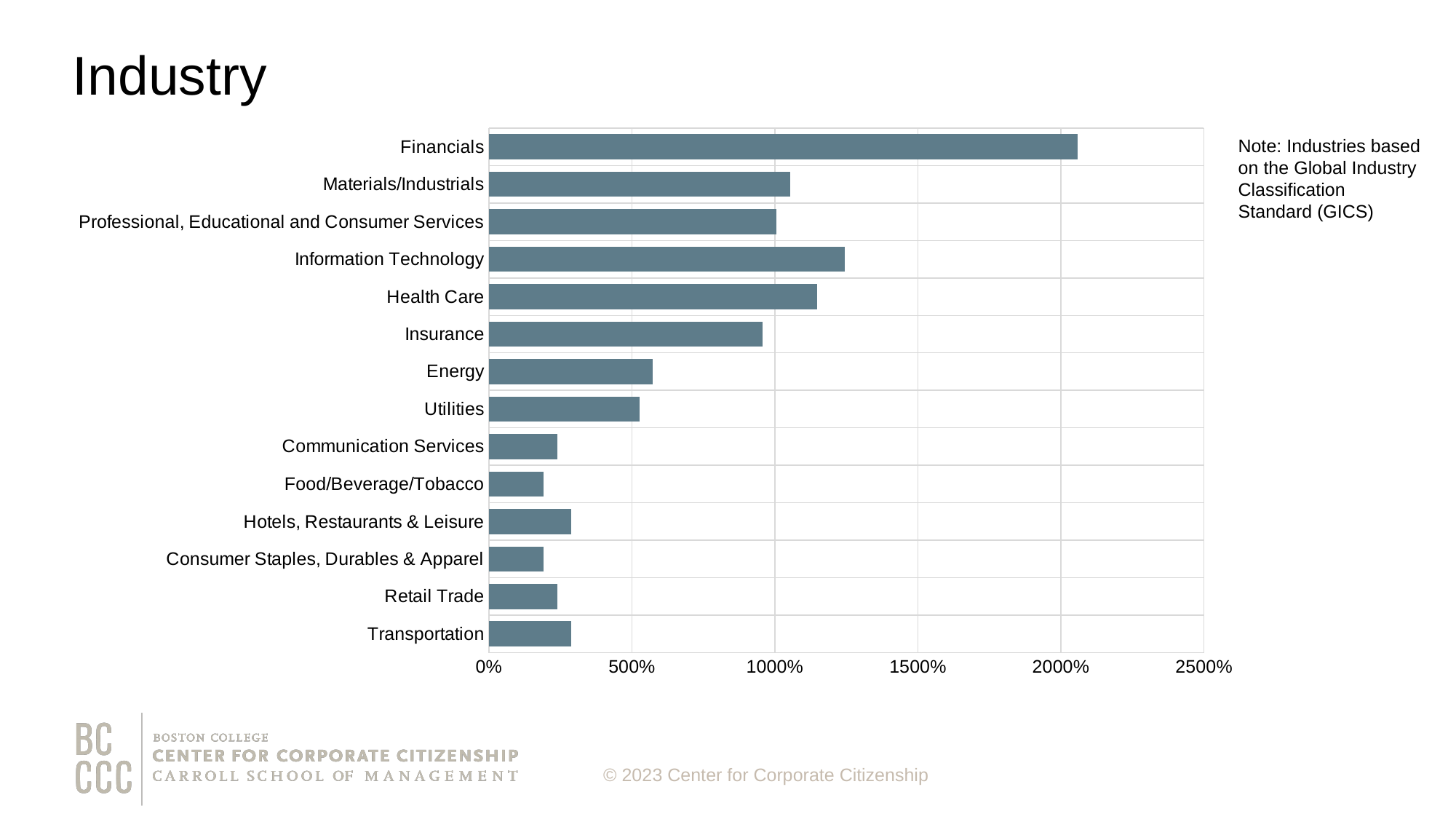
Is the value for Financials greater or less than 2000%? greater Is the value for Communication Services greater or less than 500%? less Is the value for Insurance greater or less than 1000%? less Which has the larger value, Information Technology or Health Care? Information Technology Which industry has the highest value in the chart? Financials According to the note on the slide, what standard are the industries based on? Global Industry Classification Standard (GICS) How many industries are plotted in the chart? 14 What kind of chart is shown on the slide? bar chart What is the title of the slide containing the chart? Industry Which has the larger value, Energy or Utilities? Energy